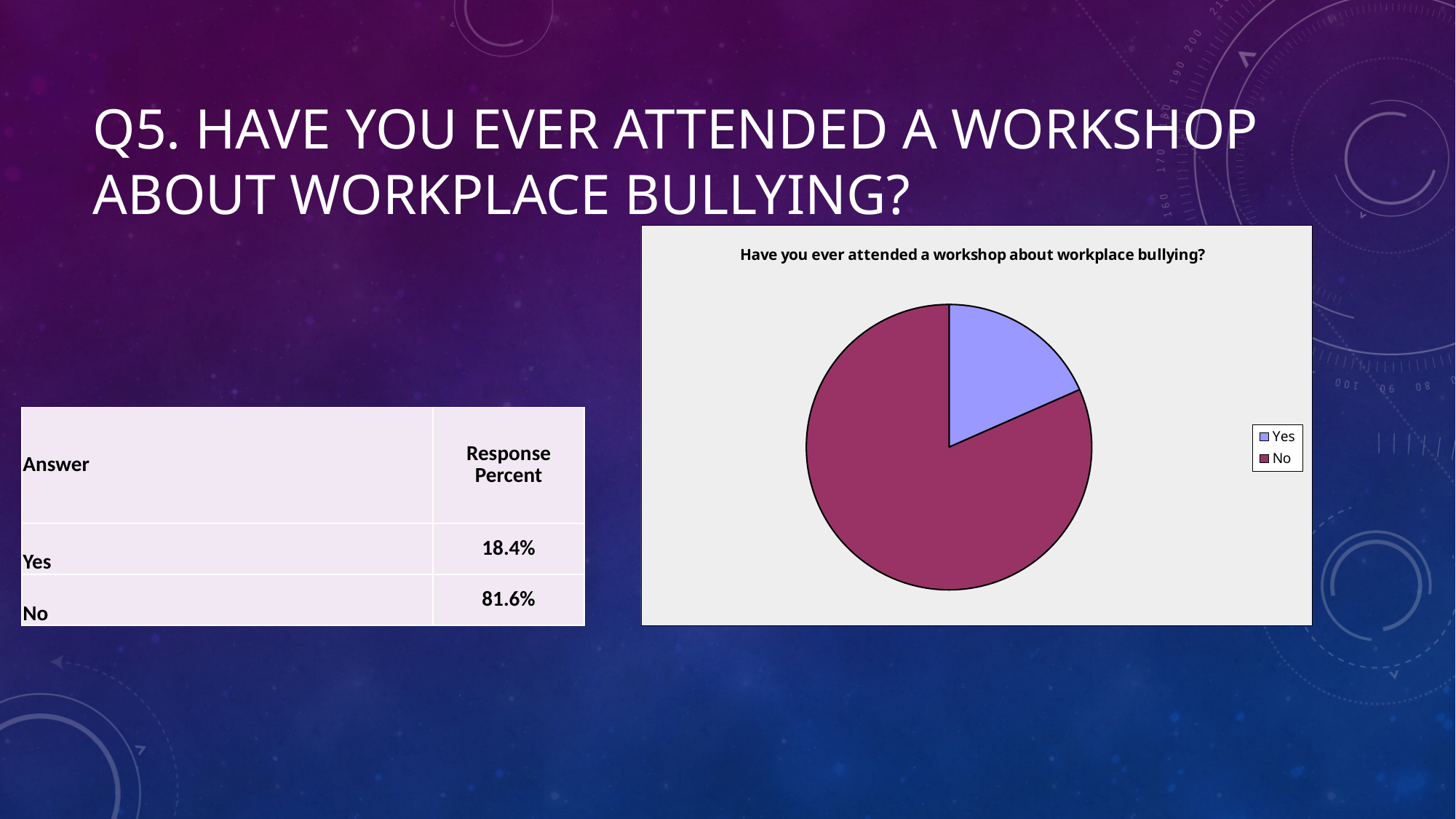
How many slices does the pie chart have? 2 What share of responses does the Yes slice represent? 18.4% Which answer has the smallest slice of the pie? Yes Which colour represents the No slice in the pie chart? dark red What is the difference between the response percent for No and for Yes? 63.2% What share of responses does the No slice represent? 81.6% What is the title of the chart? Have you ever attended a workshop about workplace bullying? Is the slice for Yes larger or smaller than the slice for No? smaller Which answer has the largest slice of the pie? No What kind of chart is shown on the slide? pie chart How many entries does the chart's legend list? 2 Is the share for No greater or less than 50%? greater